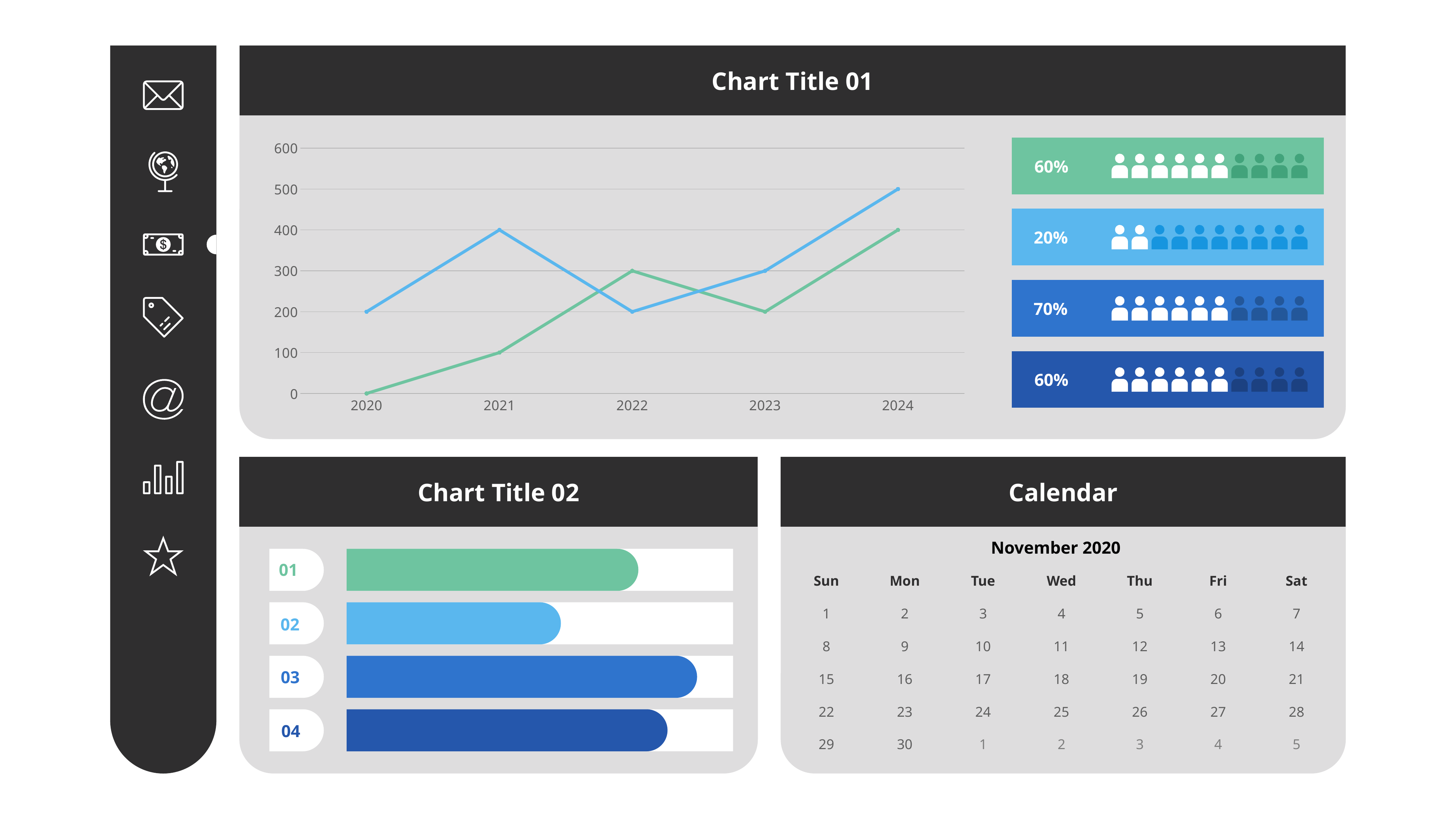
In Chart Title 01, what is the value of the blue line in 2024? 500 In Chart Title 02, which bar is the longest? 03 In Chart Title 01, what is the difference between the blue line and the green line in 2023? 100 In Chart Title 01, what kind of chart is shown? line chart In Chart Title 01, does the green line rise or fall from 2023 to 2024? rise In Chart Title 01, in which year is the green line lowest? 2020 In Chart Title 01, which line has the higher value in 2022, blue or green? green In Chart Title 01, how many years are plotted on the x axis? 5 In Chart Title 01, what is the value of the green line in 2022? 300 In Chart Title 02, what kind of chart is shown? bar chart In Chart Title 01, in which year is the blue line highest? 2024 In Chart Title 01, what is the value of the blue line in 2021? 400